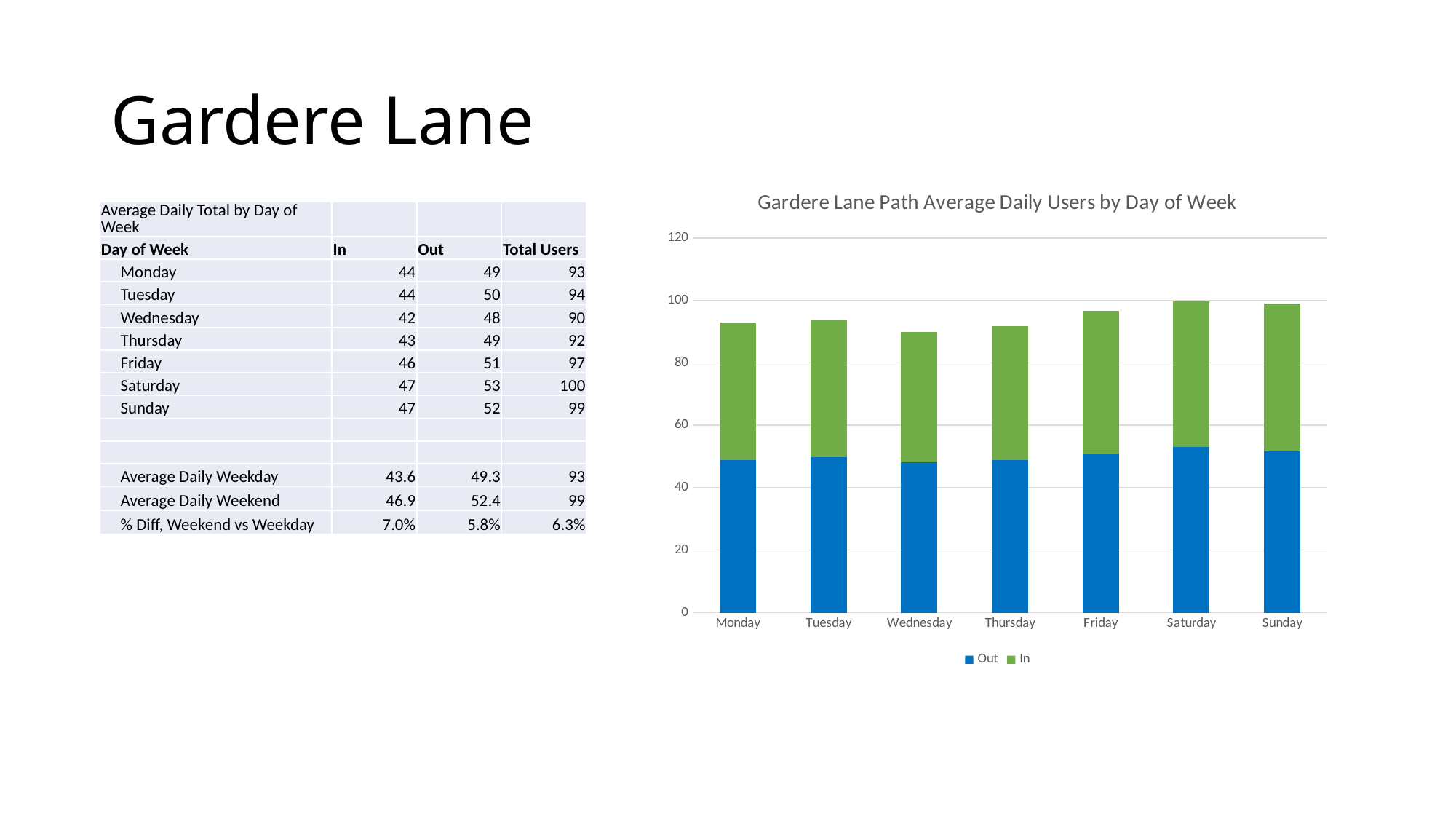
What is the total of the stacked bar for Friday? 97 What is the Out value for Saturday? 53 Is the total stacked bar for Monday greater or less than 100? less What is the difference between the Out value and the In value for Sunday? 5 What kind of chart is shown on the slide? stacked bar chart Which day has the lowest total users? Wednesday How many series does the chart legend list? 2 Which series is shown in blue in the chart? Out Which day has the highest total users? Saturday What is the title of the chart? Gardere Lane Path Average Daily Users by Day of Week How many days of the week are plotted on the x axis of the chart? 7 What is the In value for Wednesday? 42